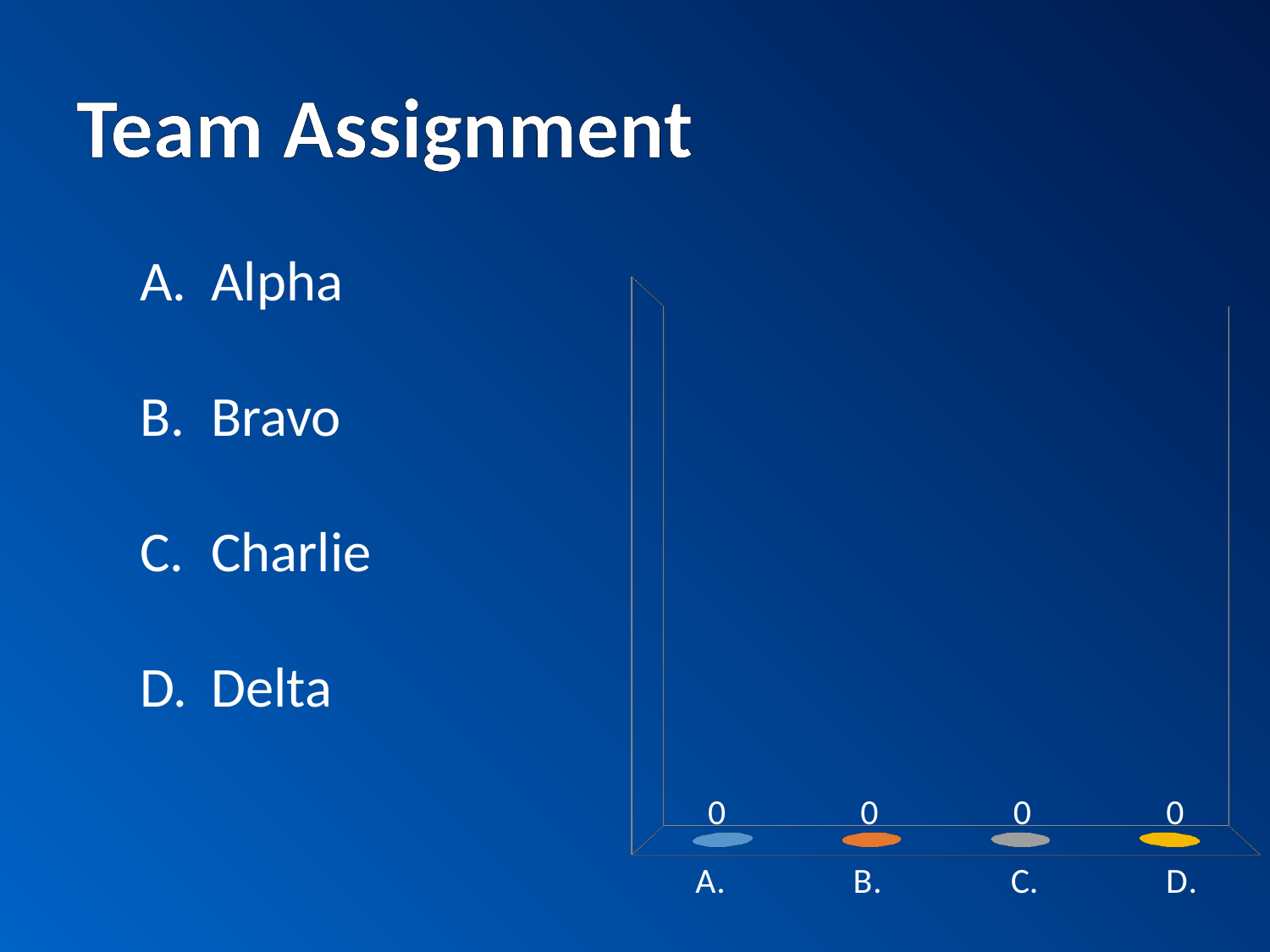
Do the values rise, fall, or stay flat from A. to D.? stay flat What kind of chart is shown on the slide? bar chart What colour is the marker for category A. in the chart? blue What is the value for category A. in the chart? 0 How many categories are shown on the x axis of the chart? 4 What is the value for category B. in the chart? 0 What is the value for category D. in the chart? 0 What is the value for category C. in the chart? 0 What is the difference between the values for A. and D.? 0 Are all four categories in the chart labelled with the same value? Yes What colour is the marker for category D. in the chart? yellow